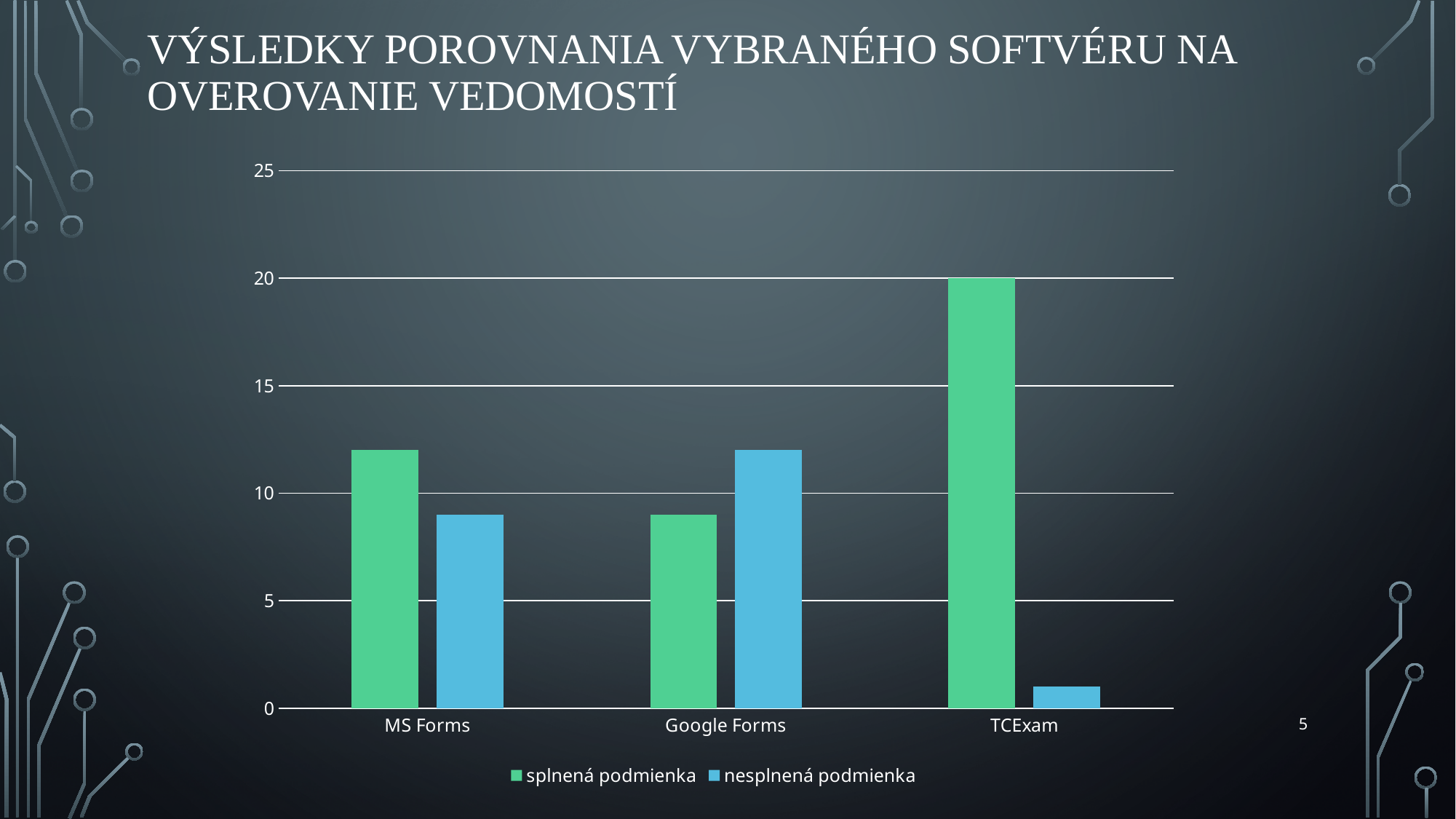
Is the value of 'nesplnená podmienka' for TCExam greater or less than 5? less Is the value of 'splnená podmienka' for MS Forms greater or less than 10? greater Is the value of 'nesplnená podmienka' for Google Forms greater or less than 10? greater Which series is shown in green in the legend? splnená podmienka How many series does the legend list? 2 For MS Forms, which is larger: 'splnená podmienka' or 'nesplnená podmienka'? splnená podmienka What type of chart is shown on the slide? bar chart What is the value of 'splnená podmienka' for TCExam? 20 Which category has the lowest value for 'nesplnená podmienka'? TCExam Which category has the highest value for 'nesplnená podmienka'? Google Forms Which category has the highest value for 'splnená podmienka'? TCExam How many software categories are shown on the x axis? 3